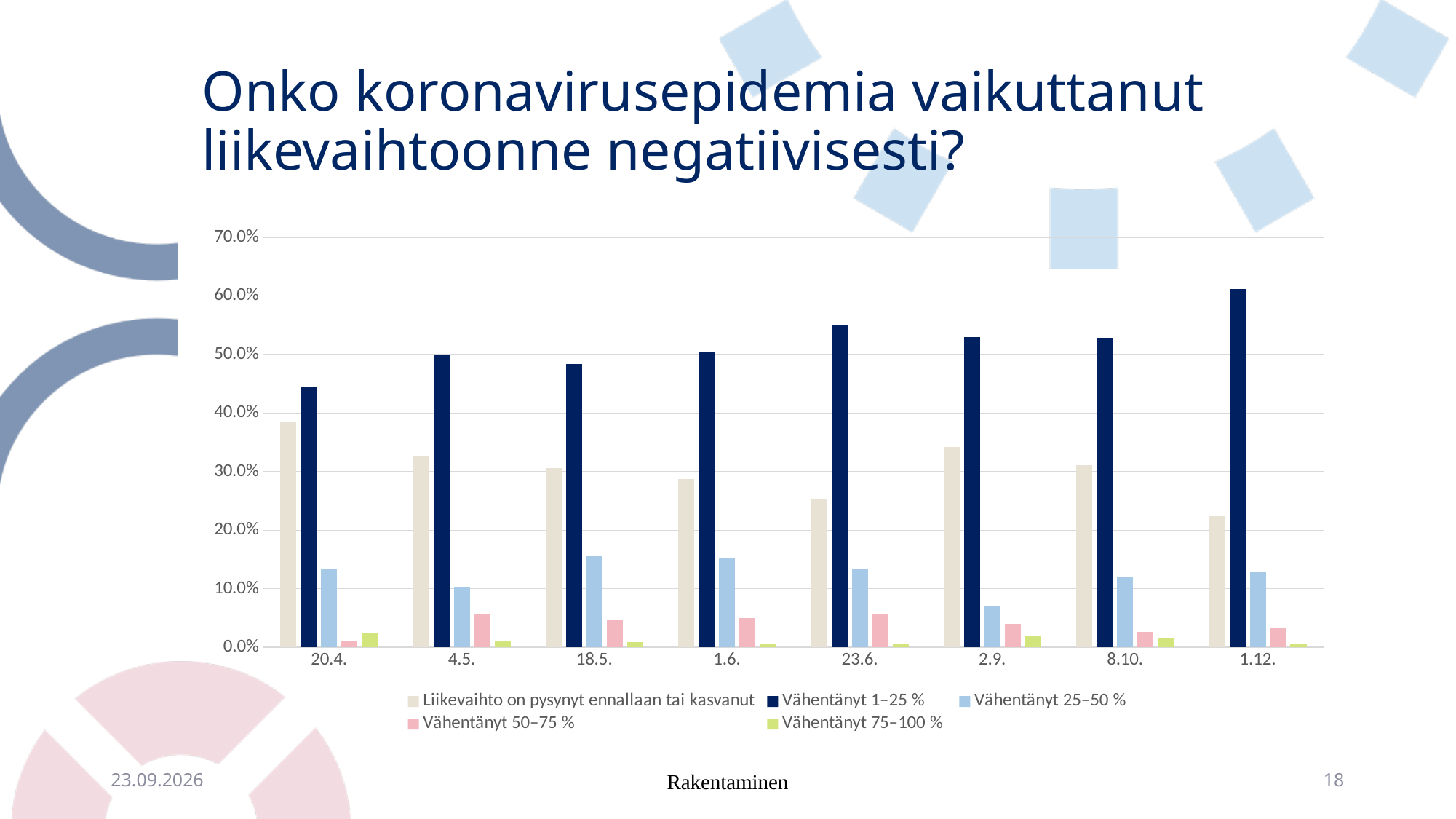
What kind of chart is shown on the slide? bar chart At which date is the value for 'Liikevaihto on pysynyt ennallaan tai kasvanut' lowest? 1.12. At 1.12., which is larger: 'Vähentänyt 1–25 %' or 'Liikevaihto on pysynyt ennallaan tai kasvanut'? Vähentänyt 1–25 % What is the title of the chart slide? Onko koronavirusepidemia vaikuttanut liikevaihtoonne negatiivisesti? Is the value for 'Vähentänyt 25–50 %' at 2.9. greater or less than 10.0%? less Is the value for 'Liikevaihto on pysynyt ennallaan tai kasvanut' at 20.4. greater or less than 30.0%? greater At which date is the value for 'Vähentänyt 1–25 %' highest? 1.12. At which date is the value for 'Liikevaihto on pysynyt ennallaan tai kasvanut' highest? 20.4. Is the value for 'Vähentänyt 1–25 %' at 1.12. greater or less than 50.0%? greater At which date is the value for 'Vähentänyt 1–25 %' lowest? 20.4. How many survey dates (categories) are shown on the x axis? 8 How many series does the legend list? 5